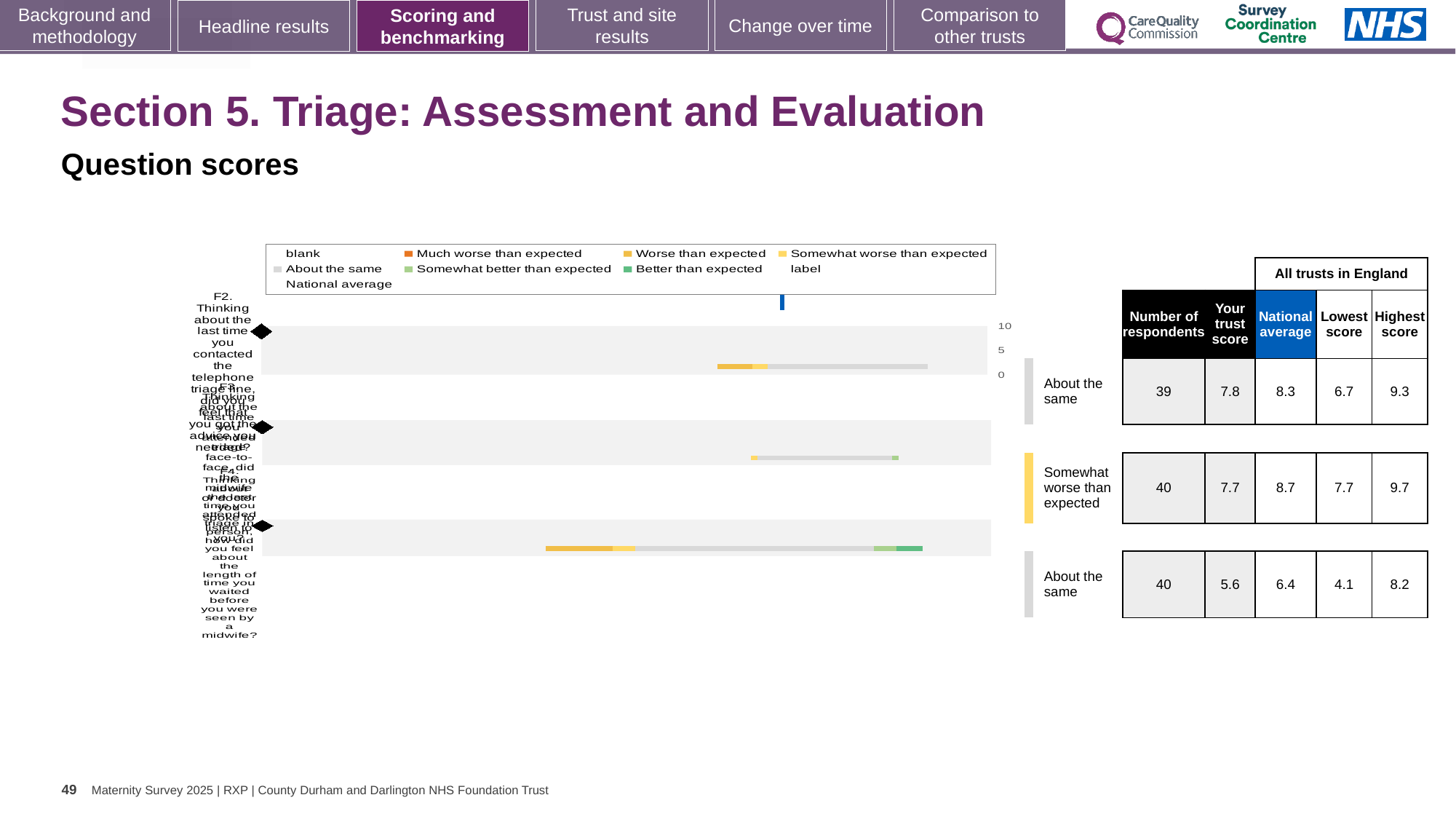
Which question row has the highest trust score in the table beside the chart? the first (top) row How many question rows (bars) does the chart show? 3 What benchmark category is shown for the second question row? Somewhat worse than expected What kind of chart is shown on the slide? bar chart According to the table beside the chart, what is the trust score for the first (top) question row? 7.8 Which question row has the lowest trust score in the table beside the chart? the third (bottom) row For the second question row, which is larger: the trust score or the national average? the national average What colour does the legend use for 'Better than expected'? green According to the table beside the chart, what is the lowest score among all trusts in England for the third question row? 4.1 According to the table beside the chart, what is the national average for the second question row? 8.7 For the third question row, what is the difference between the national average and the trust score? 0.8 According to the table beside the chart, what is the trust score for the third (bottom) question row? 5.6